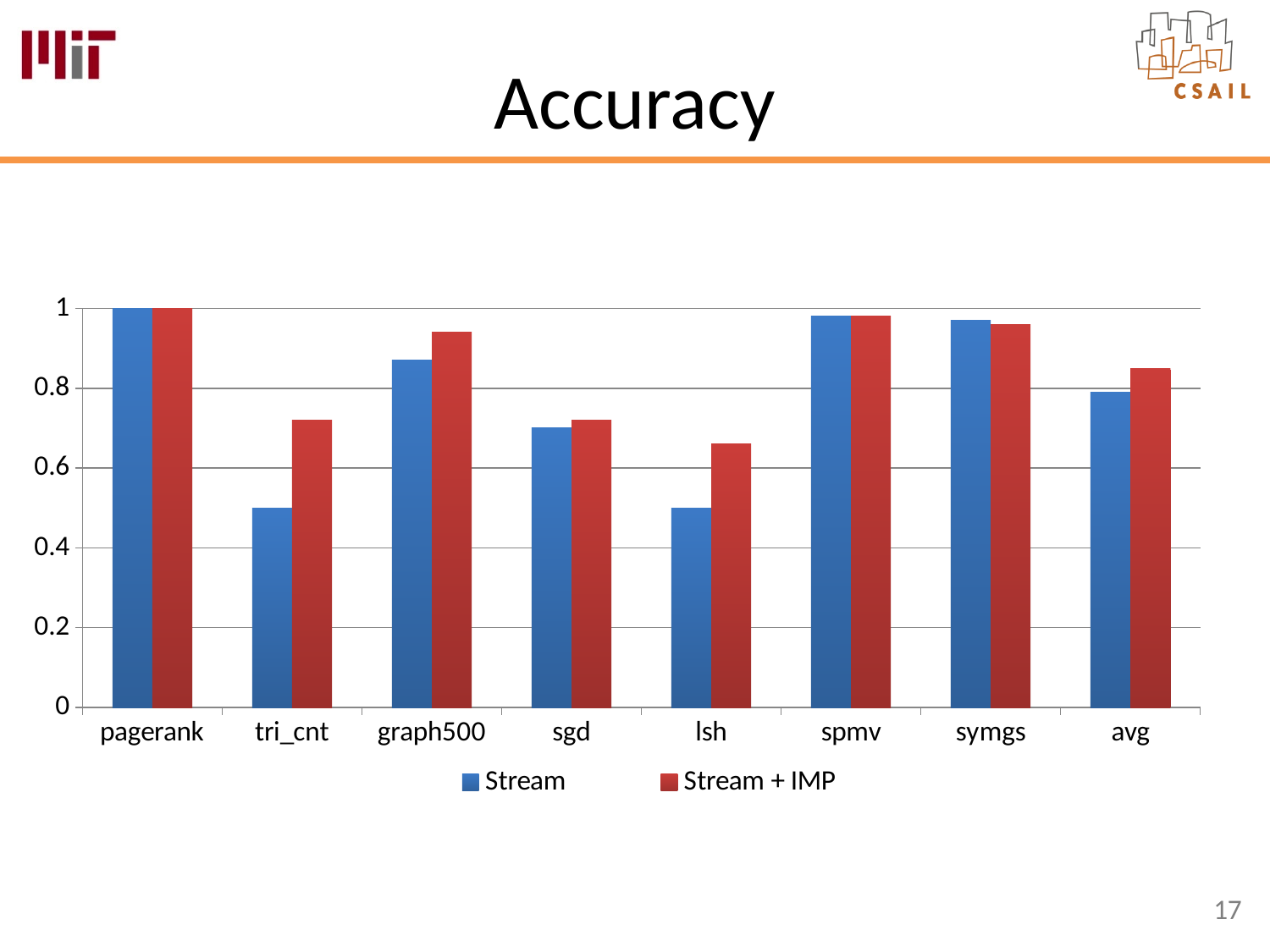
Which category has the lowest Stream + IMP value? lsh Is the Stream value for tri_cnt greater or less than 0.6? less What is the title of the chart? Accuracy How many categories are shown on the x axis? 8 How many series does the legend list? 2 What are the two series named in the legend? Stream and Stream + IMP Is the Stream value for graph500 greater or less than 0.8? greater Is the Stream + IMP value for avg greater or less than 0.8? greater For lsh, which series has the larger value, Stream or Stream + IMP? Stream + IMP What is the Stream value for pagerank? 1 What kind of chart is shown on the slide? bar chart